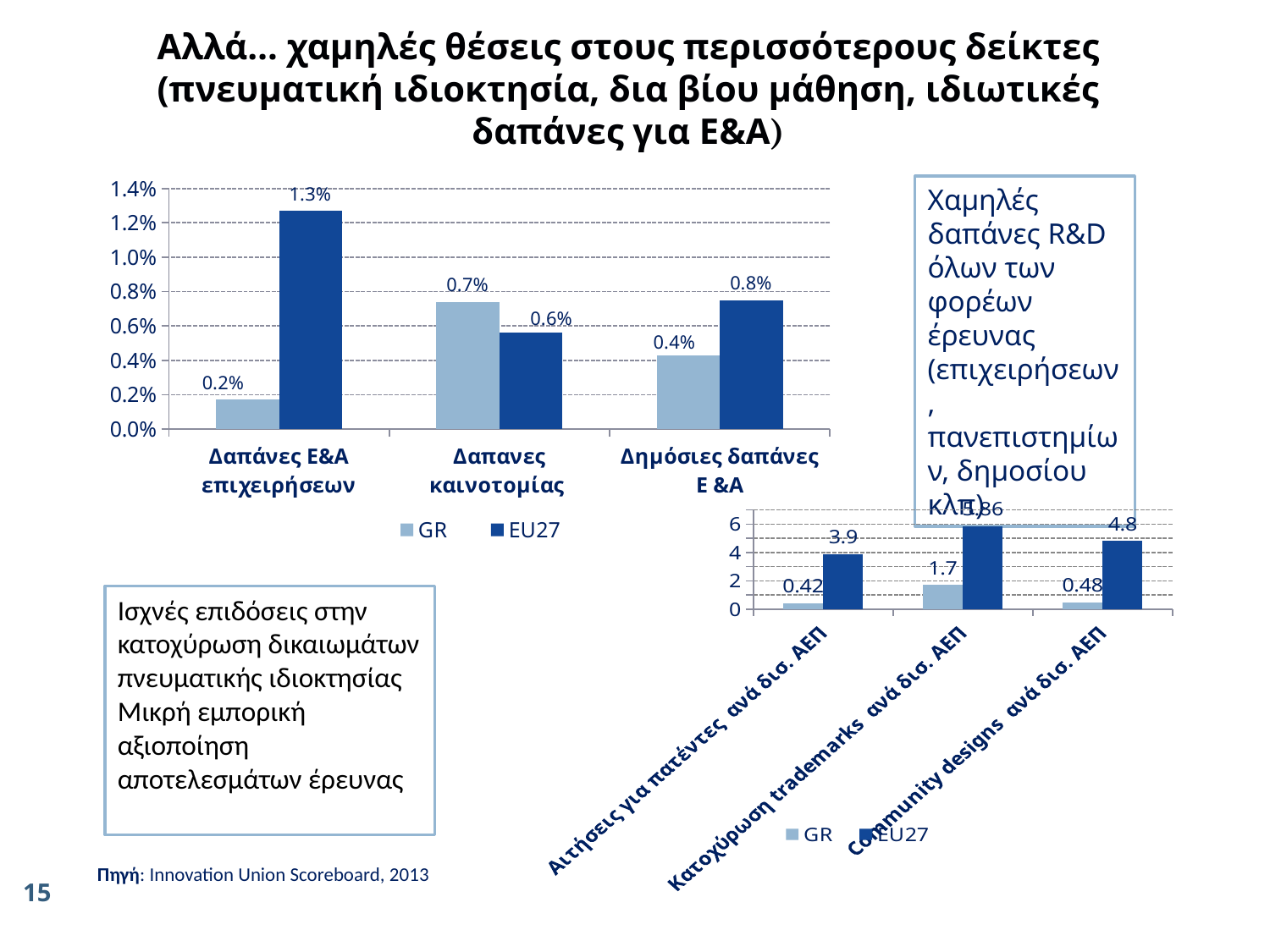
In the top-left chart, what is the EU27 value for Δημόσιες δαπάνες Ε&Α? 0.8% In the top-left chart, what is the GR value for Δαπάνες Ε&Α επιχειρήσεων? 0.2% In the bottom-right chart, what is the GR value for Αιτήσεις για πατέντες ανά δισ. ΑΕΠ? 0.42 How many series does the legend of the top-left chart list? 2 In the top-left chart, what is the EU27 value for Δαπάνες Ε&Α επιχειρήσεων? 1.3% In the top-left chart, what is the difference between the EU27 and GR values for Δαπάνες Ε&Α επιχειρήσεων? 1.1% In the bottom-right chart, what is the EU27 value for Community designs ανά δισ. ΑΕΠ? 4.8 In the top-left chart, for Δαπανες καινοτομίας, which series has the larger value, GR or EU27? GR In the bottom-right chart, what is the GR value for Κατοχύρωση trademarks ανά δισ. ΑΕΠ? 1.7 In the top-left chart, what is the GR value for Δαπανες καινοτομίας? 0.7% What kind of chart is the bottom-right chart? Bar chart In the top-left chart, which category has the highest EU27 value? Δαπάνες Ε&Α επιχειρήσεων